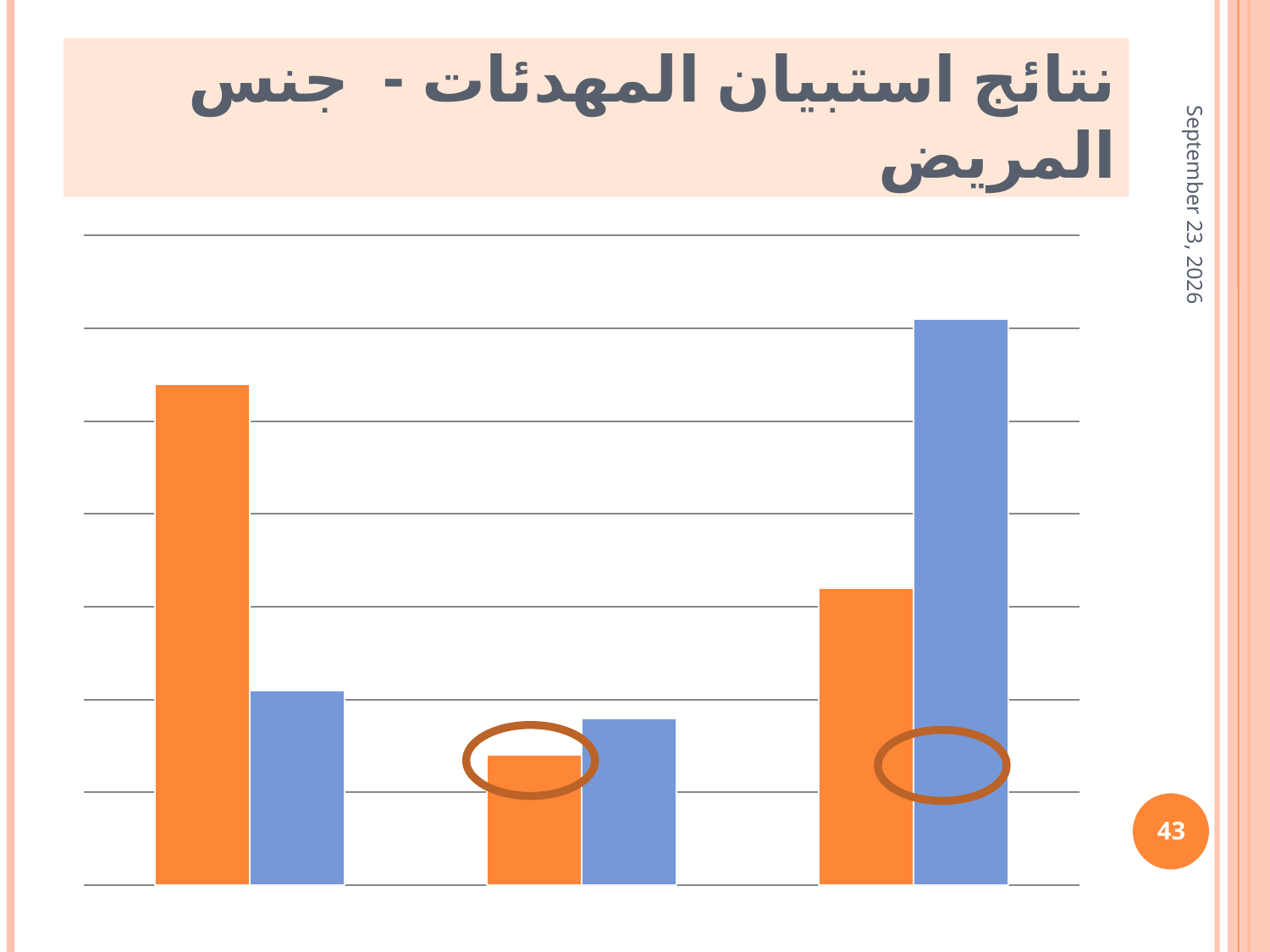
In the leftmost group, which bar is taller, the orange one or the blue one? the orange one Is the orange bar in the rightmost group taller or shorter than the orange bar in the leftmost group? shorter In the rightmost group, which bar is taller, the orange one or the blue one? the blue one How many bars are plotted in total on the chart? 6 How many differently coloured bar series appear in the chart? 2 How many groups of bars does the chart show? 3 Among the orange bars, which group has the tallest one? the leftmost group What are the two colours of the bars in the chart? orange and blue Among the blue bars, which group has the tallest one? the rightmost group Which bar is the tallest in the whole chart? the blue bar in the rightmost group What kind of chart is shown on the slide? bar chart Which bar is the shortest in the whole chart? the orange bar in the middle group